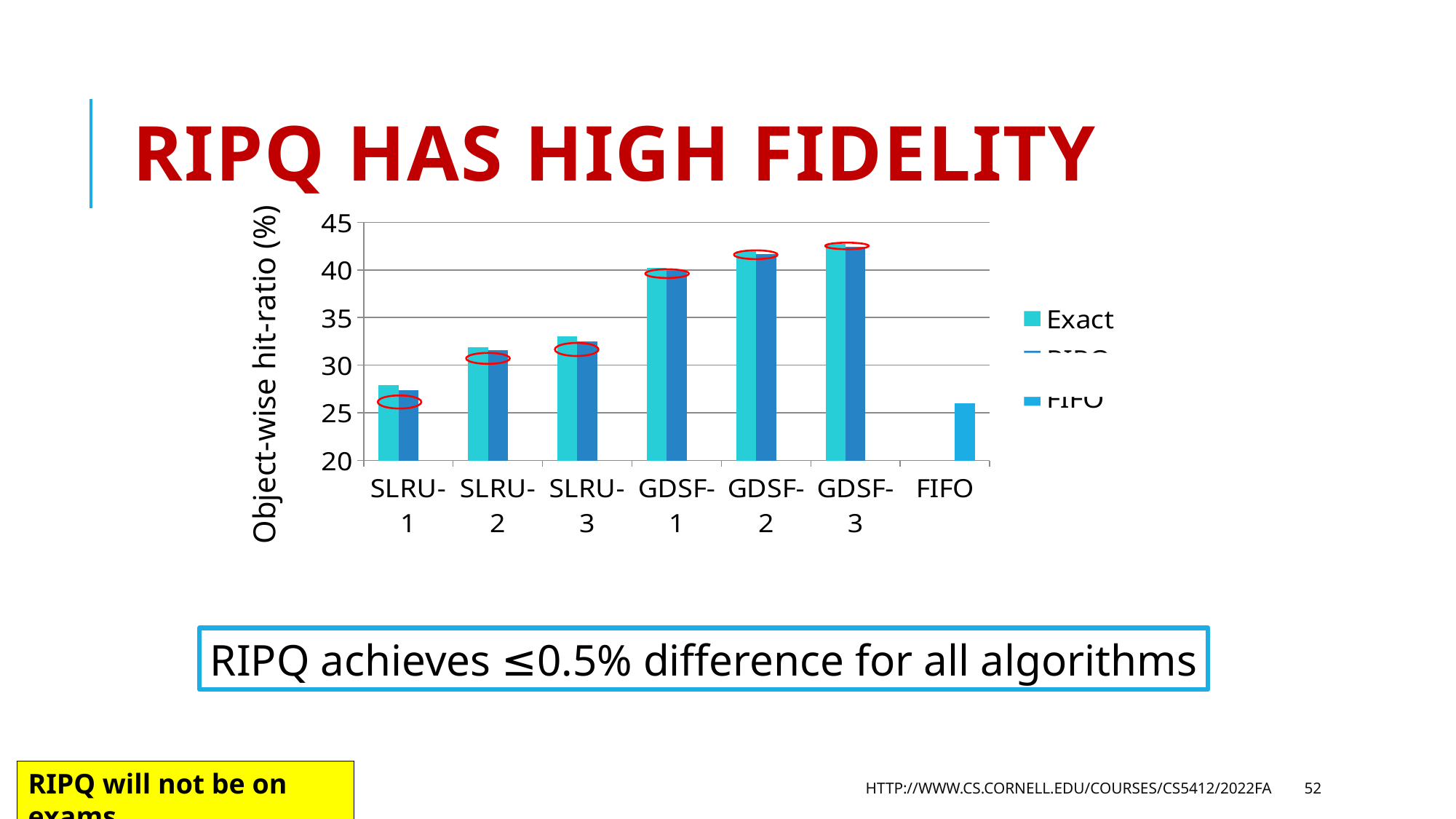
How many categories are shown along the x axis of the chart? 7 Which category has the highest Exact value? GDSF-3 Is the Exact value for GDSF-1 greater or less than 35? greater Is the Exact value for GDSF-3 greater or less than 40? greater Is the value for FIFO greater or less than 30? less What kind of chart is shown on the slide? bar chart What is the label of the y axis of the chart? Object-wise hit-ratio (%) Which category has the lowest Exact value? SLRU-1 Which has the larger Exact value, SLRU-3 or GDSF-1? GDSF-1 What is the first entry in the chart's legend? Exact How many series does the chart's legend list? 3